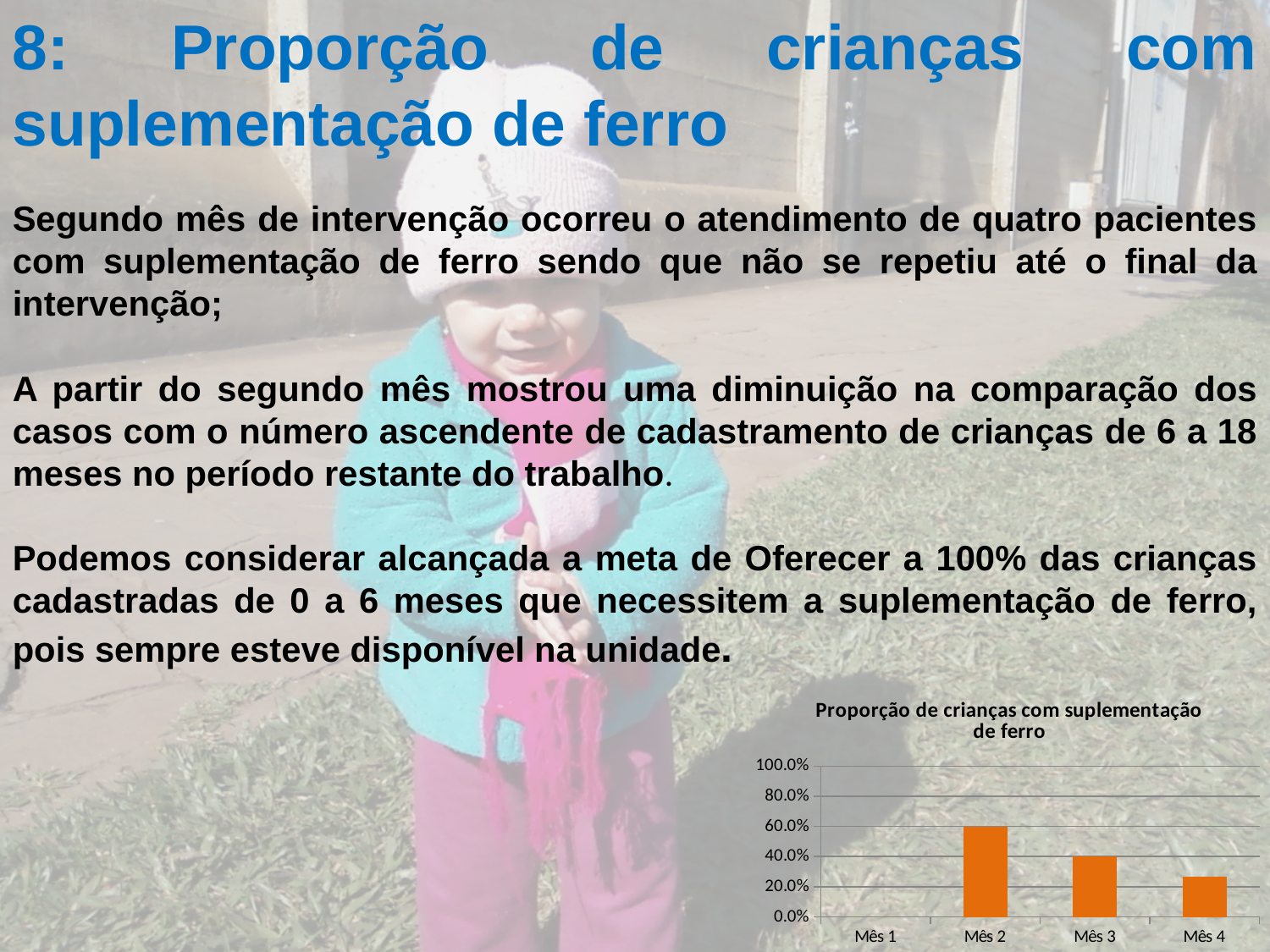
Which is larger, the value for Mês 3 or the value for Mês 4? Mês 3 Which month has the lowest proportion of children with iron supplementation? Mês 1 Is the value for Mês 2 greater or less than 40.0%? greater Which is larger, the value for Mês 2 or the value for Mês 3? Mês 2 How many months (categories) are shown on the x axis of the chart? 4 Is the value for Mês 4 greater or less than 40.0%? less Is the value for Mês 3 greater or less than 20.0%? greater What is the title of the chart? Proporção de crianças com suplementação de ferro From Mês 2 to Mês 4, do the values rise or fall? fall Which month has the highest proportion of children with iron supplementation? Mês 2 What kind of chart is shown on the slide? bar chart